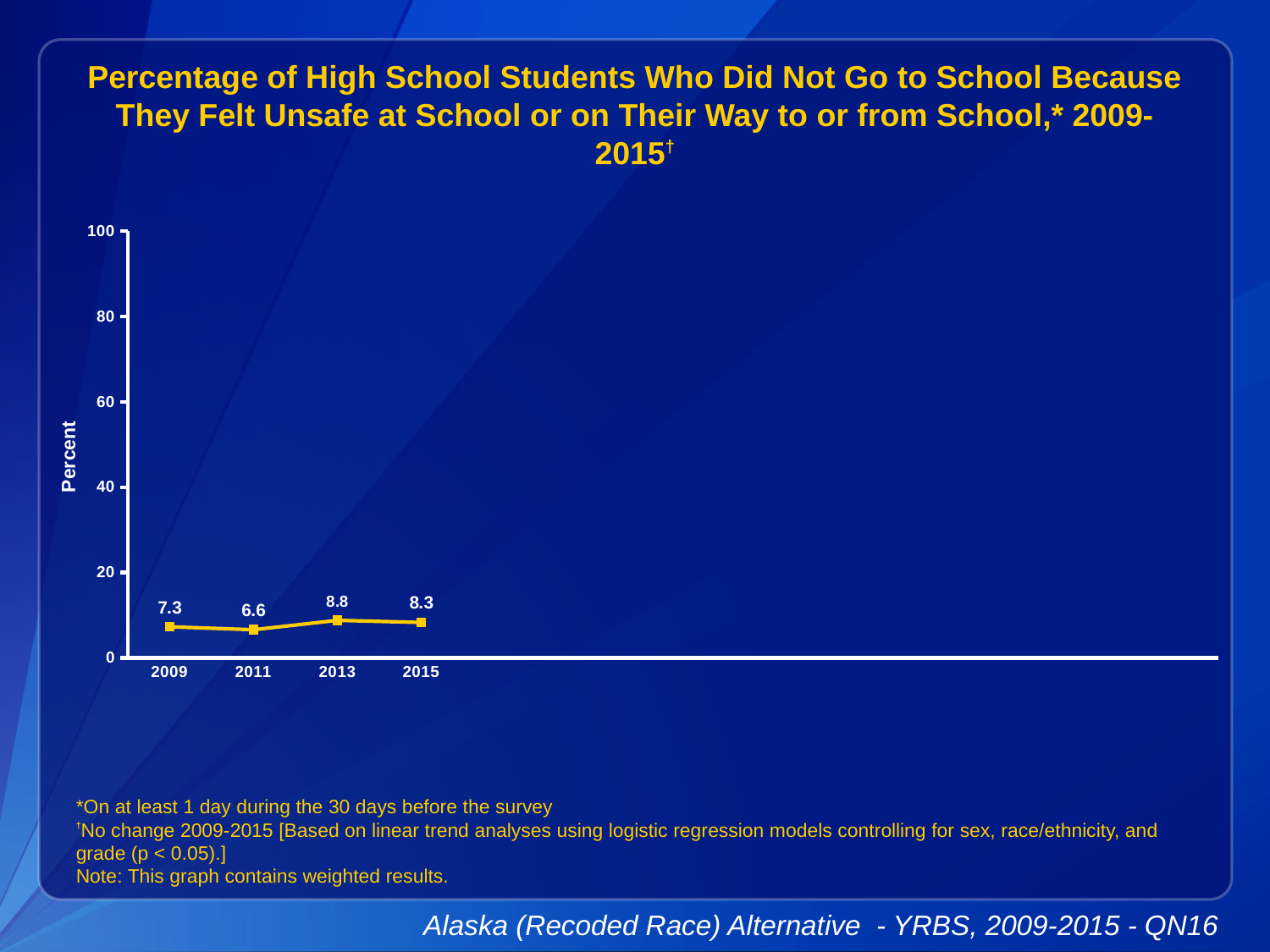
Which is larger, the value for 2009 or the value for 2015? 2015 Which year has the lowest value? 2011 What is the value for 2013? 8.8 What is the value for 2009? 7.3 Which year has the highest value? 2013 Is the value for 2013 greater or less than 20? less What is the label on the vertical axis? Percent How many years are plotted on the chart? 4 What is the value for 2015? 8.3 What kind of chart is shown on the slide? line chart What is the difference between the values for 2013 and 2011? 2.2 What is the value for 2011? 6.6